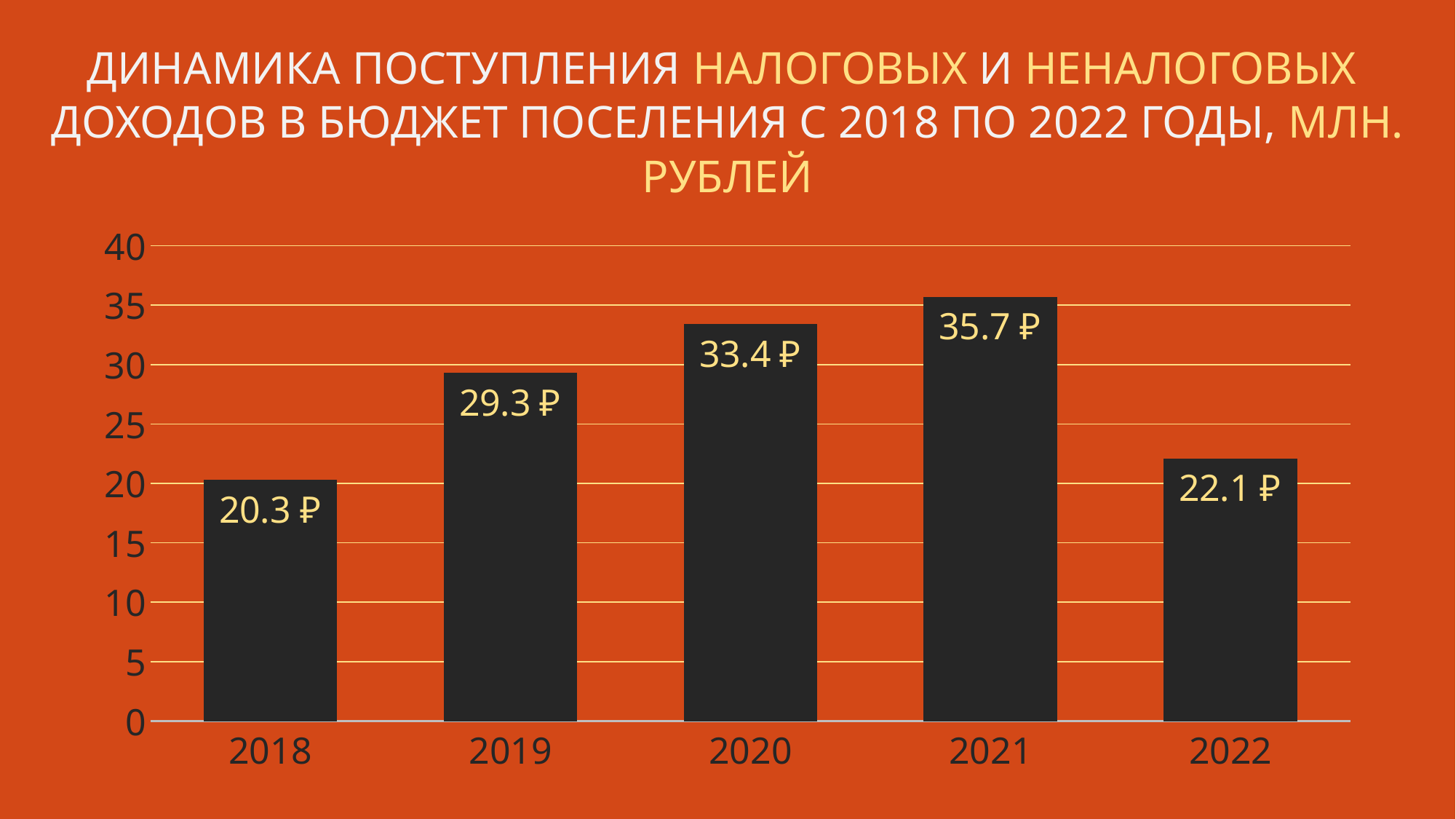
How many years are shown on the x axis? 5 What is the difference between the values for 2019 and 2022? 7.2 What is the difference between the values for 2021 and 2018? 15.4 Which year has the highest value? 2021 Do the values rise or fall from 2018 to 2021? rise What is the value for 2020? 33.4 ₽ Which year has the lowest value? 2018 What kind of chart is shown on the slide? bar chart What is the value for 2022? 22.1 ₽ What is the value for 2018? 20.3 ₽ Is the value for 2021 greater or less than 30? greater Which is larger, the value for 2019 or the value for 2022? 2019